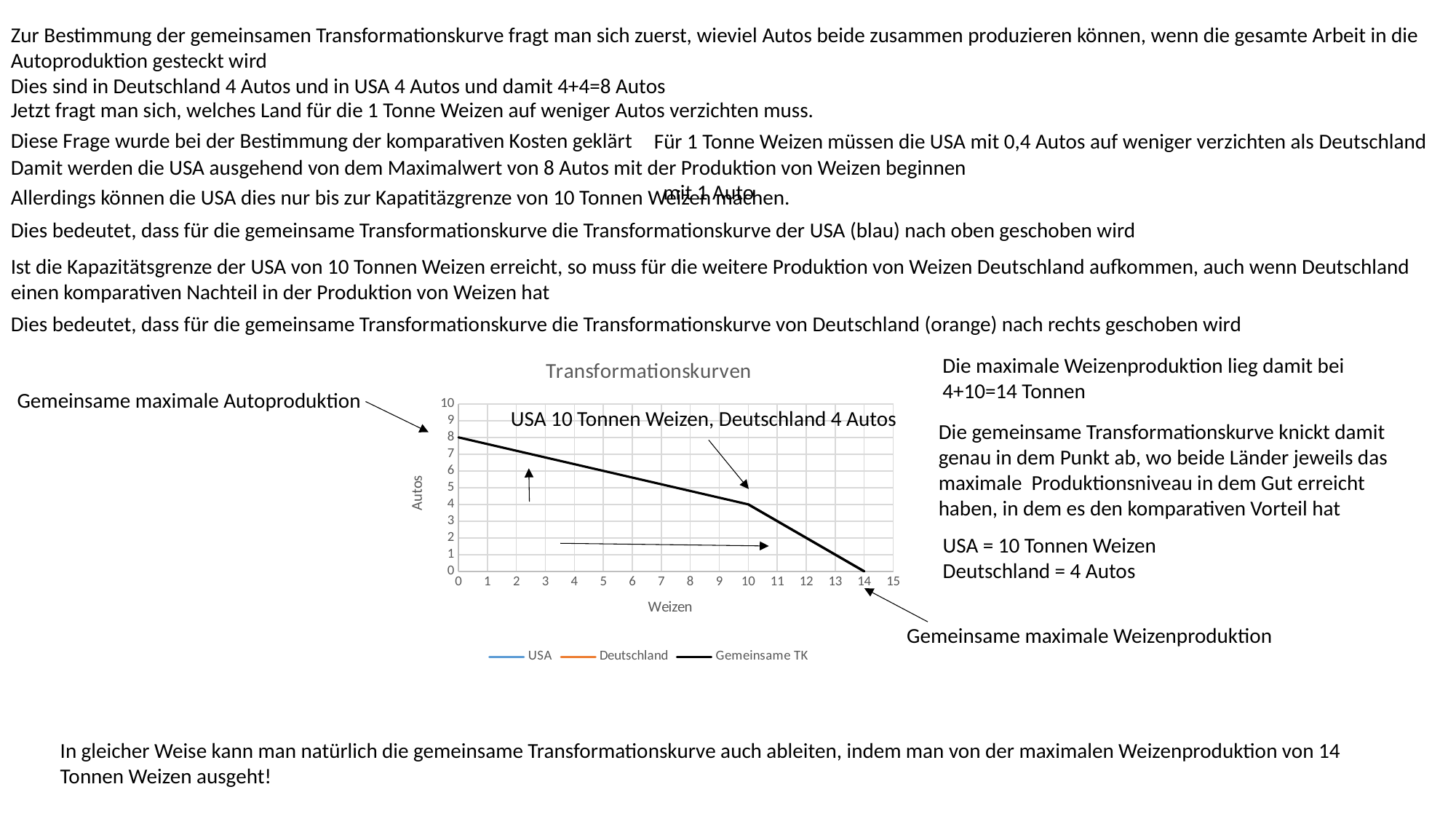
In the "Transformationskurven" chart, how many Autos does the Gemeinsame TK line show at Weizen = 10? 4 In the "Transformationskurven" chart, how many Autos does the Gemeinsame TK line show at Weizen = 0? 8 What are the axis titles of the "Transformationskurven" chart? Weizen (x axis) and Autos (y axis) How many series does the legend of the "Transformationskurven" chart list? 3 In the "Transformationskurven" chart, is the Gemeinsame TK value at Weizen = 5 greater or less than 7 Autos? less In the "Transformationskurven" chart, at what Weizen value does the Gemeinsame TK line reach 0 Autos? 14 What kind of chart is shown under the title "Transformationskurven"? line chart In the "Transformationskurven" chart, what is the difference in Autos between the Gemeinsame TK value at Weizen = 0 and at Weizen = 10? 4 What is the title of the chart on the slide? Transformationskurven In the "Transformationskurven" chart, is the Gemeinsame TK value at Weizen = 12 greater or less than 4 Autos? less Does the Gemeinsame TK line in the "Transformationskurven" chart rise or fall as Weizen increases? fall In the "Transformationskurven" chart, which is larger: the Gemeinsame TK value at Weizen = 0 or at Weizen = 10? Weizen = 0